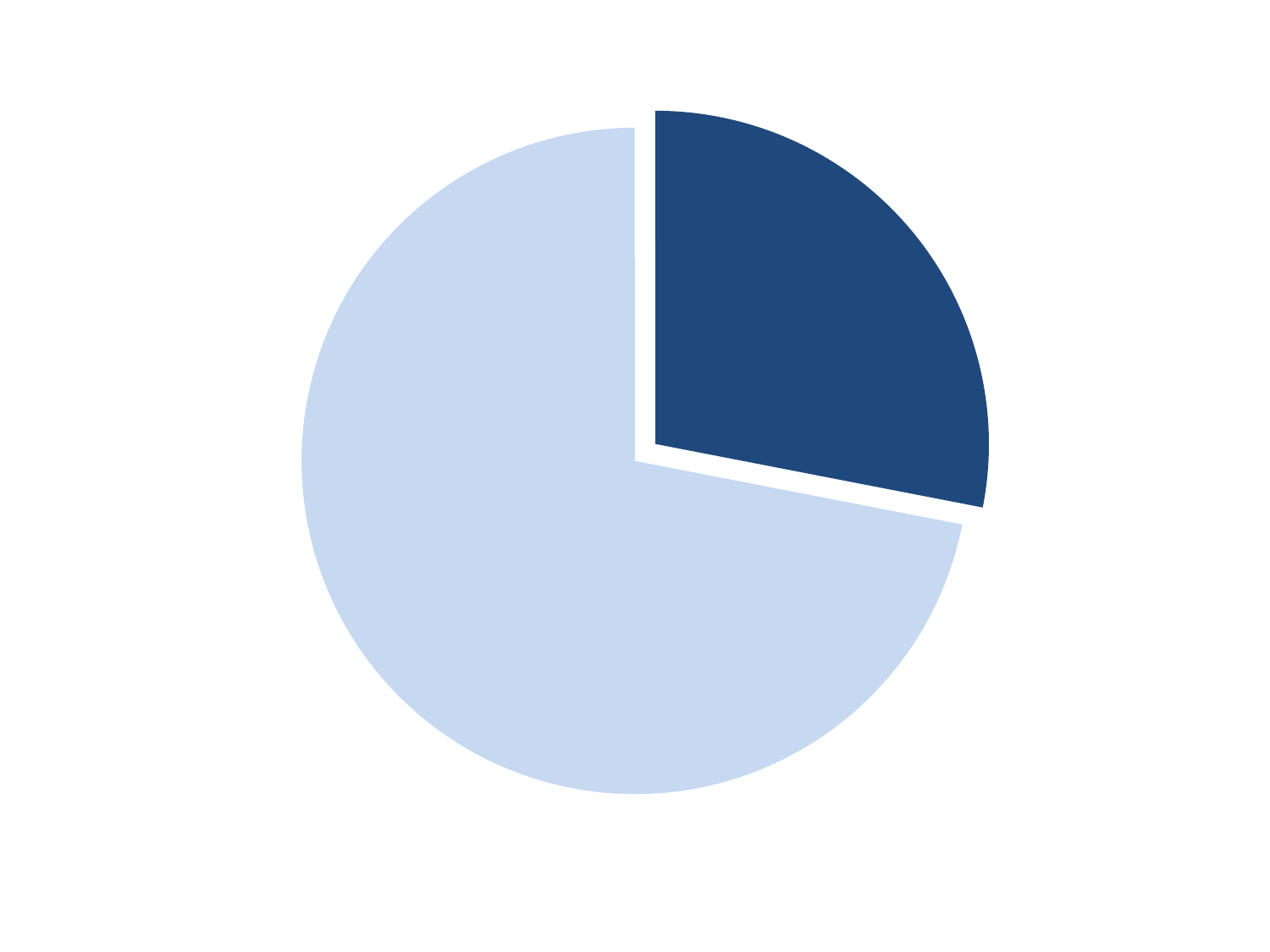
How many slices does the pie chart have? 2 Which slice of the pie chart is the largest? the light blue slice Which slice of the pie chart is pulled out (exploded) from the rest of the pie? the dark blue slice Which slice of the pie chart is the smallest? the dark blue slice What kind of chart is shown on the slide? pie chart Does the pie chart display a legend? no Which slice of the pie chart is larger, the dark blue one or the light blue one? the light blue one